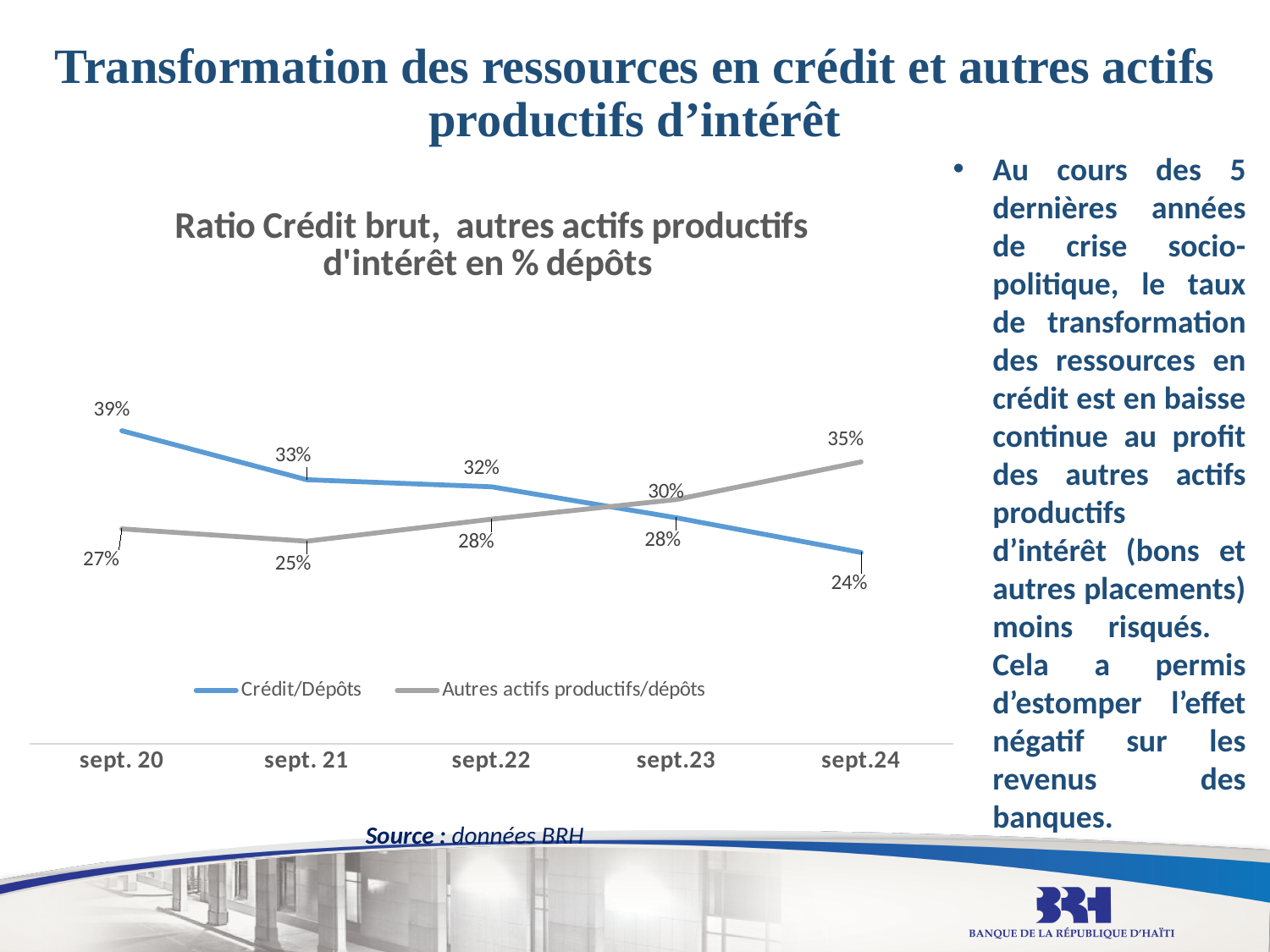
How many series does the legend list? 2 What type of chart is shown on the slide? line chart How many periods are shown on the x axis? 5 Does the Crédit/Dépôts series rise or fall from sept. 20 to sept.24? fall What is the value of Autres actifs productifs/dépôts in sept.24? 35% Which series has the larger value in sept.24, Crédit/Dépôts or Autres actifs productifs/dépôts? Autres actifs productifs/dépôts In which period is Autres actifs productifs/dépôts at its highest? sept.24 In which period is Crédit/Dépôts at its lowest? sept.24 What is the difference between Crédit/Dépôts and Autres actifs productifs/dépôts in sept. 20? 12% What is the value of Crédit/Dépôts in sept.24? 24% What is the value of Crédit/Dépôts in sept. 20? 39% What is the value of Autres actifs productifs/dépôts in sept. 21? 25%